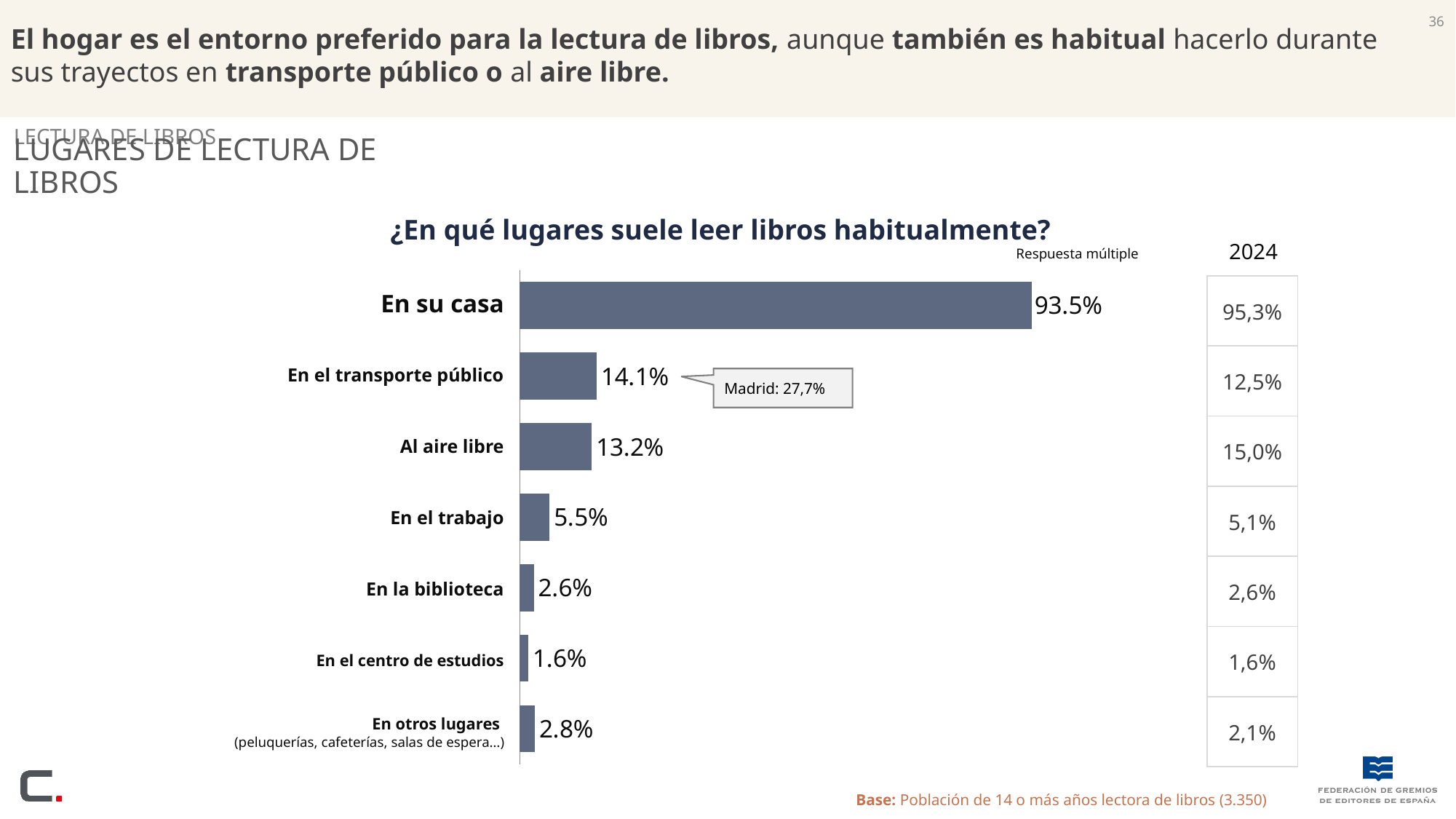
What kind of chart is used on this slide? Bar chart What is the value shown for 'Al aire libre'? 13.2% Which is larger, the value for 'En otros lugares' or the value for 'En la biblioteca'? En otros lugares What is the 2024 value shown in the side column for 'En su casa'? 95,3% How many places (categories) are shown in the chart? 7 What is the value shown for 'En la biblioteca'? 2.6% Which place has the lowest percentage in the chart? En el centro de estudios Which place has the highest percentage in the chart? En su casa What is the value shown for 'En el transporte público'? 14.1% What percentage of readers usually read books 'En su casa'? 93.5% What is the difference between the values for 'En el transporte público' and 'Al aire libre'? 0.9% What value does the callout give for Madrid on 'En el transporte público'? 27,7%